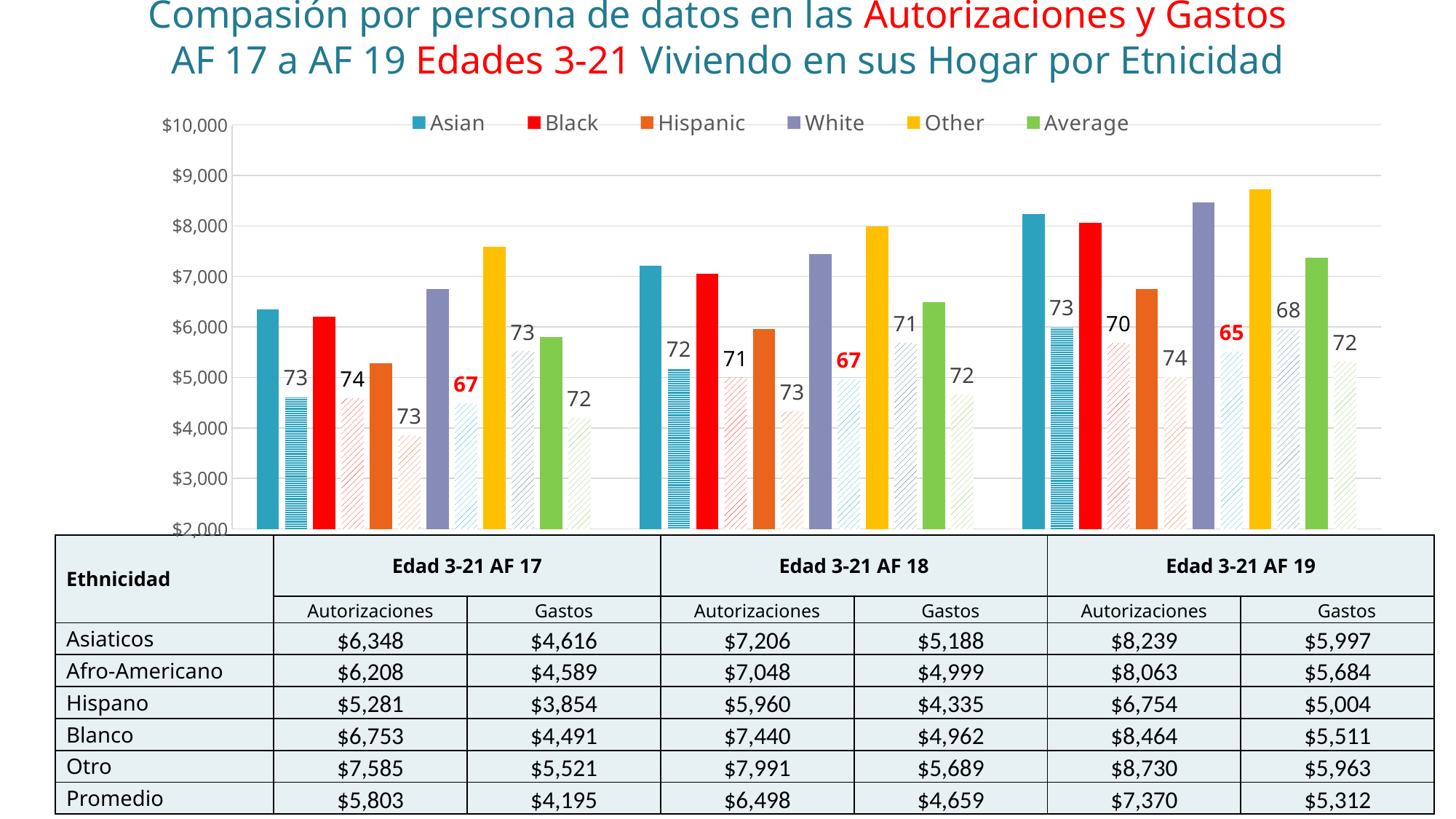
What kind of chart is shown on the slide? bar chart What is the Autorizaciones value for Asiaticos in Edad 3-21 AF 17? $6,348 What is the difference between the Autorizaciones values for Otro and Asiaticos in Edad 3-21 AF 19? $491 In Edad 3-21 AF 18, which is larger: the Autorizaciones value for Blanco or for Afro-Americano? Blanco Do the Asian Autorizaciones values rise or fall from AF 17 to AF 19? rise How many series does the chart legend list? 6 What data label is shown on the hatched Black bar in the AF 17 group? 74 Which ethnicity has the lowest Autorizaciones value in Edad 3-21 AF 17? Hispano Which ethnicity has the highest Autorizaciones value in Edad 3-21 AF 19? Otro Which legend series is shown in red? Black What is the Gastos value for Hispano in Edad 3-21 AF 18? $4,335 Is the Average Autorizaciones bar in the AF 19 group greater or less than $7,000? greater